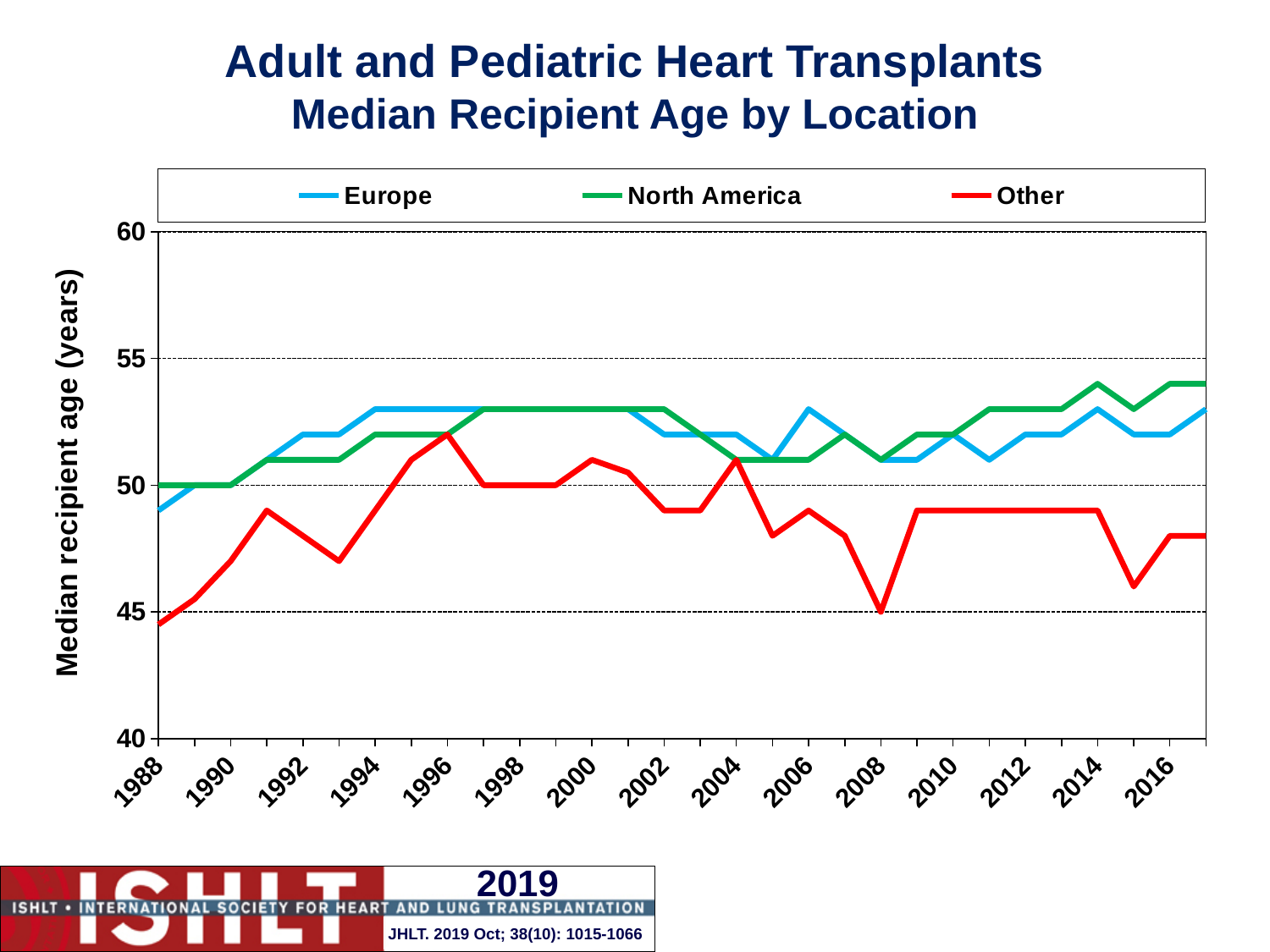
What is the median recipient age for Other in 2008? 45 What is the median recipient age for North America in 1988? 50 How many series does the legend list? 3 Is the value for North America in 2014 greater or less than 55? less What is the label of the vertical axis? Median recipient age (years) What are the three series named in the legend? Europe, North America, Other Does the Other series rise or fall between 1988 and 1992? rise Is the value for Europe in 2016 greater or less than 50? greater What kind of chart is shown on the slide? line chart Is the value for Other in 1988 greater or less than 45? less In 2008, which series has the higher median recipient age, Europe or Other? Europe Which series has the lowest median recipient age in 1988? Other